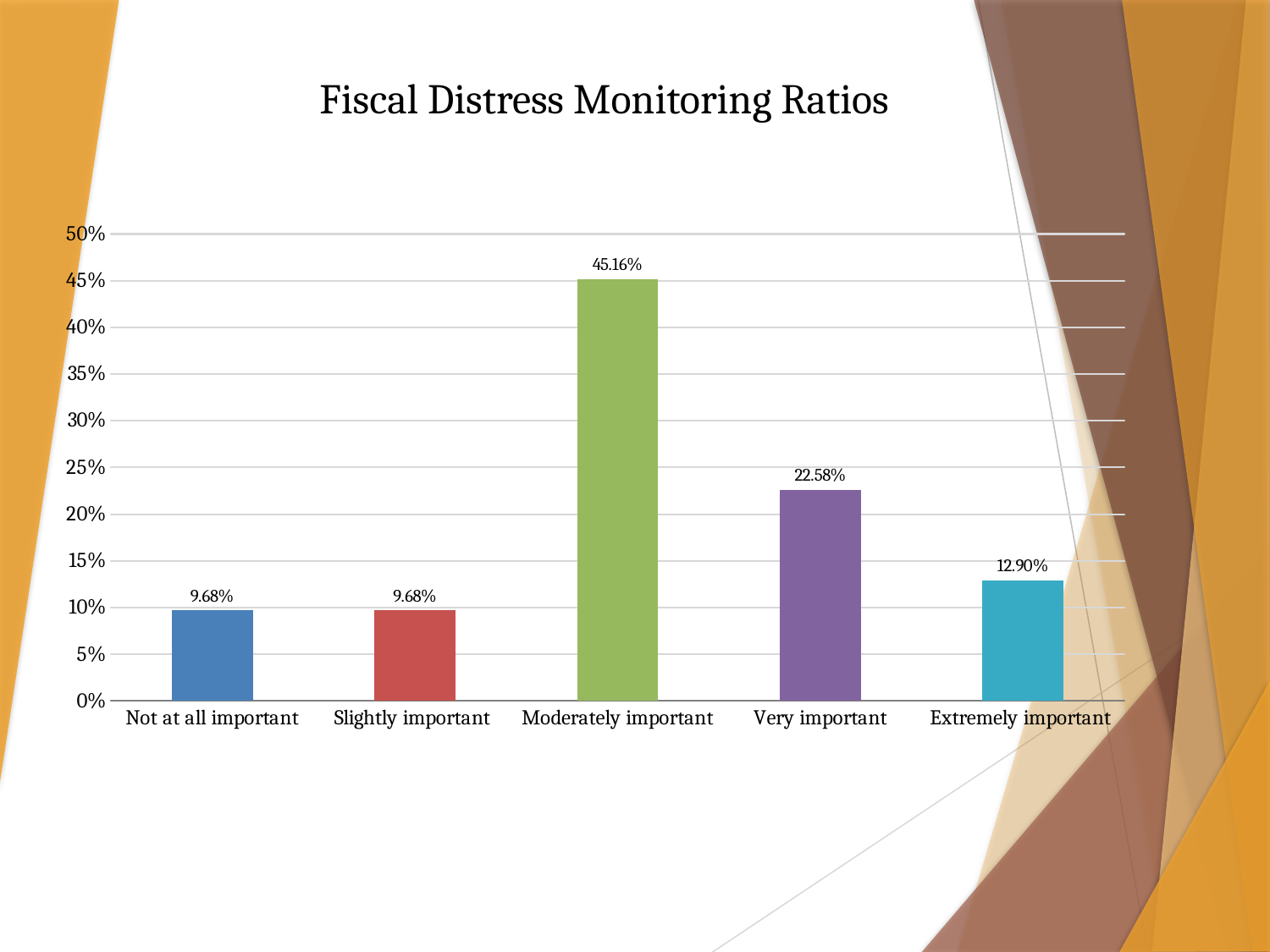
Is the value for Moderately important greater or less than 40%? greater What is the value for Extremely important? 12.90% What is the value for Very important? 22.58% How many categories are shown on the x axis? 5 What is the difference between the values for Moderately important and Very important? 22.58% Which category has the highest value? Moderately important What is the title of the chart? Fiscal Distress Monitoring Ratios What is the difference between the values for Extremely important and Slightly important? 3.22% What kind of chart is shown on the slide? bar chart What is the value for Moderately important? 45.16% What is the value for Not at all important? 9.68% Which is larger, the value for Very important or the value for Extremely important? Very important